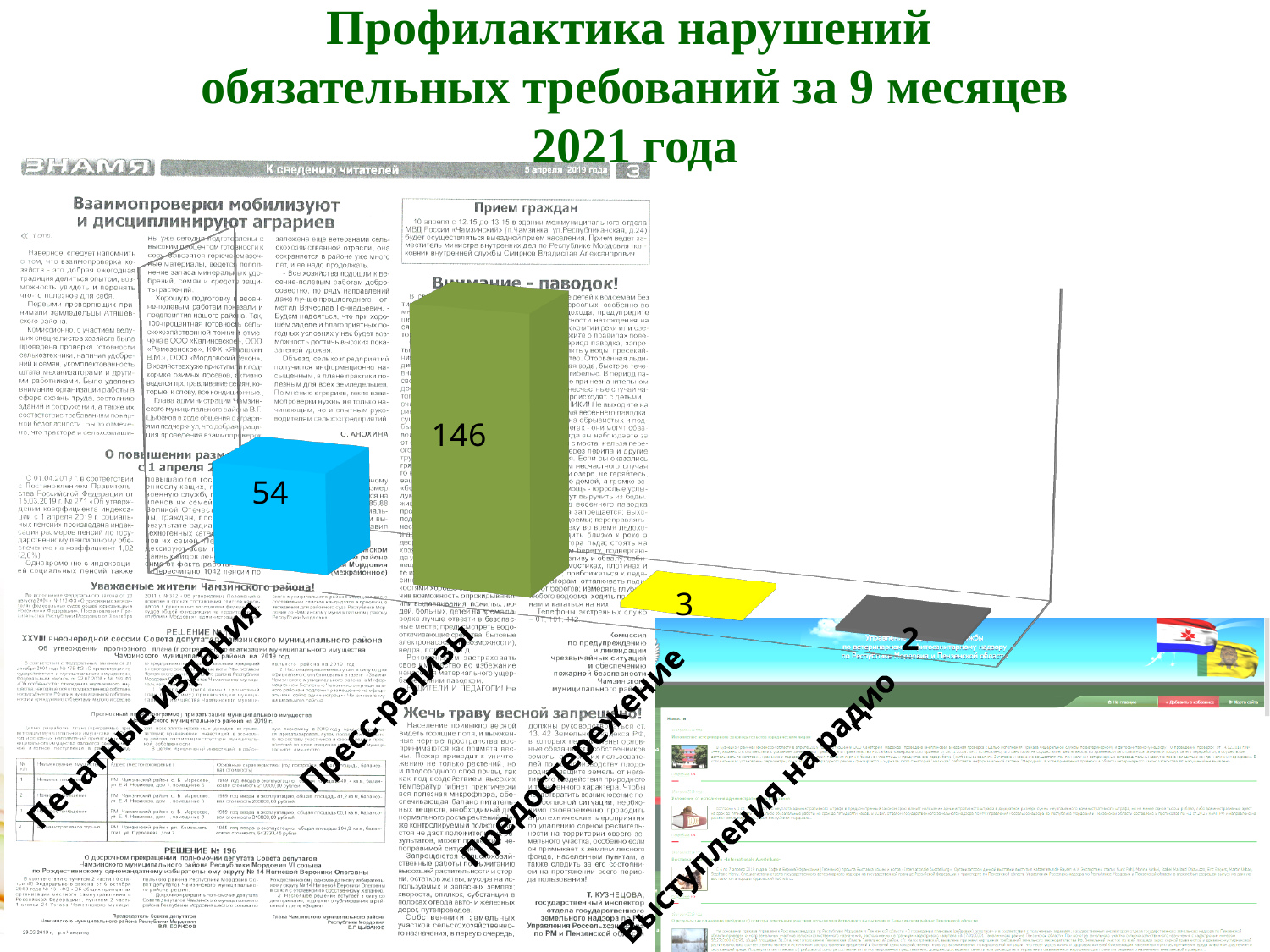
What is the difference between the values for Предостережение and Выступления на радио? 1 Which category has the highest value? Пресс-релизы Which is larger, the value for Печатные издания or the value for Предостережение? Печатные издания What is the difference between the values for Пресс-релизы and Печатные издания? 92 How many categories are shown in the chart? 4 What is the value for Пресс-релизы? 146 Which category has the lowest value? Выступления на радио What kind of chart is shown on the slide? Bar chart What is the value for Печатные издания? 54 What is the value for Выступления на радио? 2 What is the value for Предостережение? 3 What colour is the bar for Пресс-релизы? Green